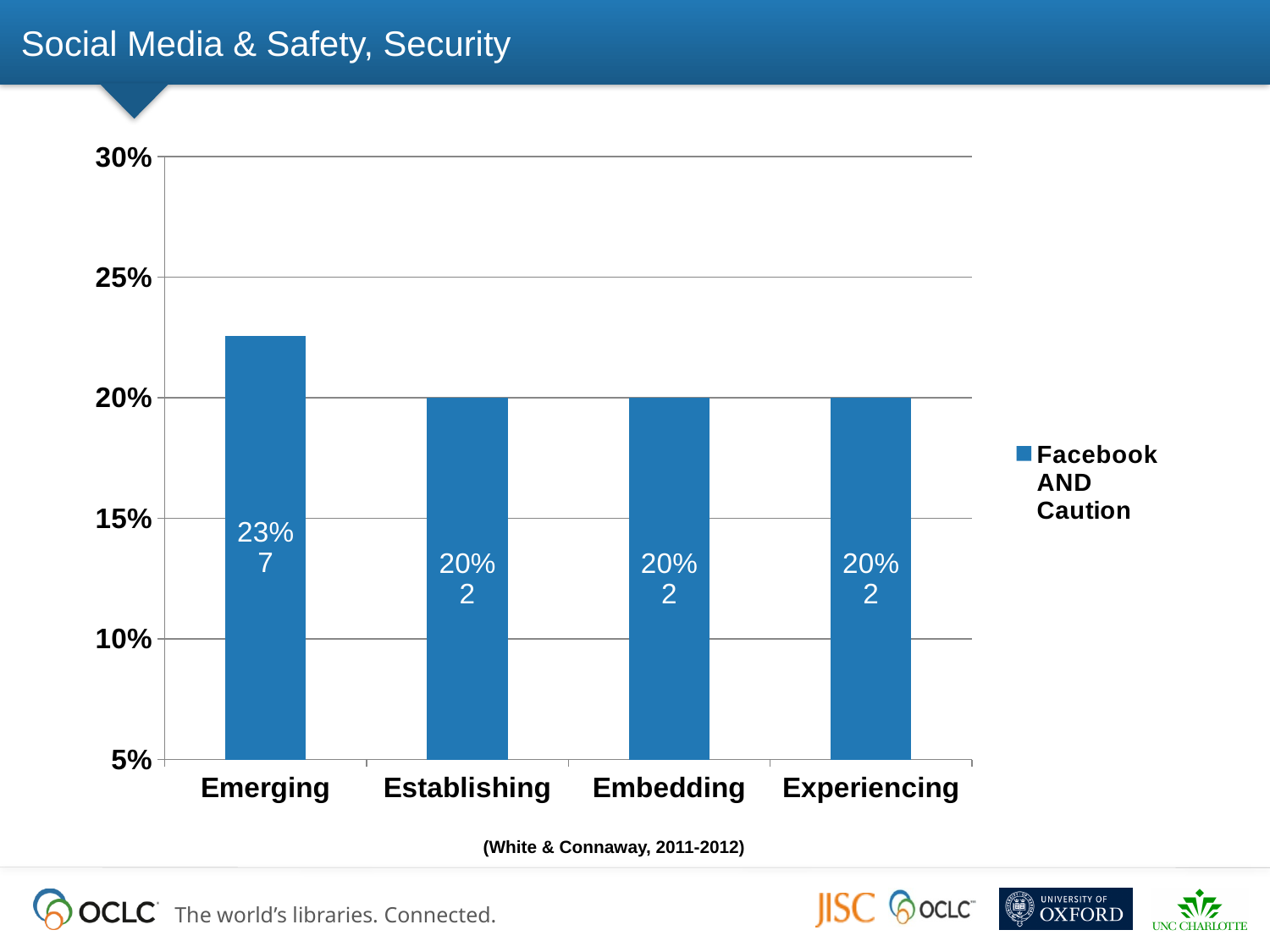
How many categories are shown on the x axis? 4 What is the percentage value for Establishing? 20% What kind of chart is shown on the slide? bar chart What is the percentage value for Experiencing? 20% What count is shown inside the Embedding bar below the percentage? 2 What is the difference in percentage points between Emerging and Establishing? 3% How many series does the legend list? 1 Which is larger, the value for Emerging or the value for Embedding? Emerging What count is shown inside the Emerging bar below the percentage? 7 What is the percentage value for Emerging? 23% Is the value for Emerging greater or less than 25%? less Which category has the highest percentage? Emerging